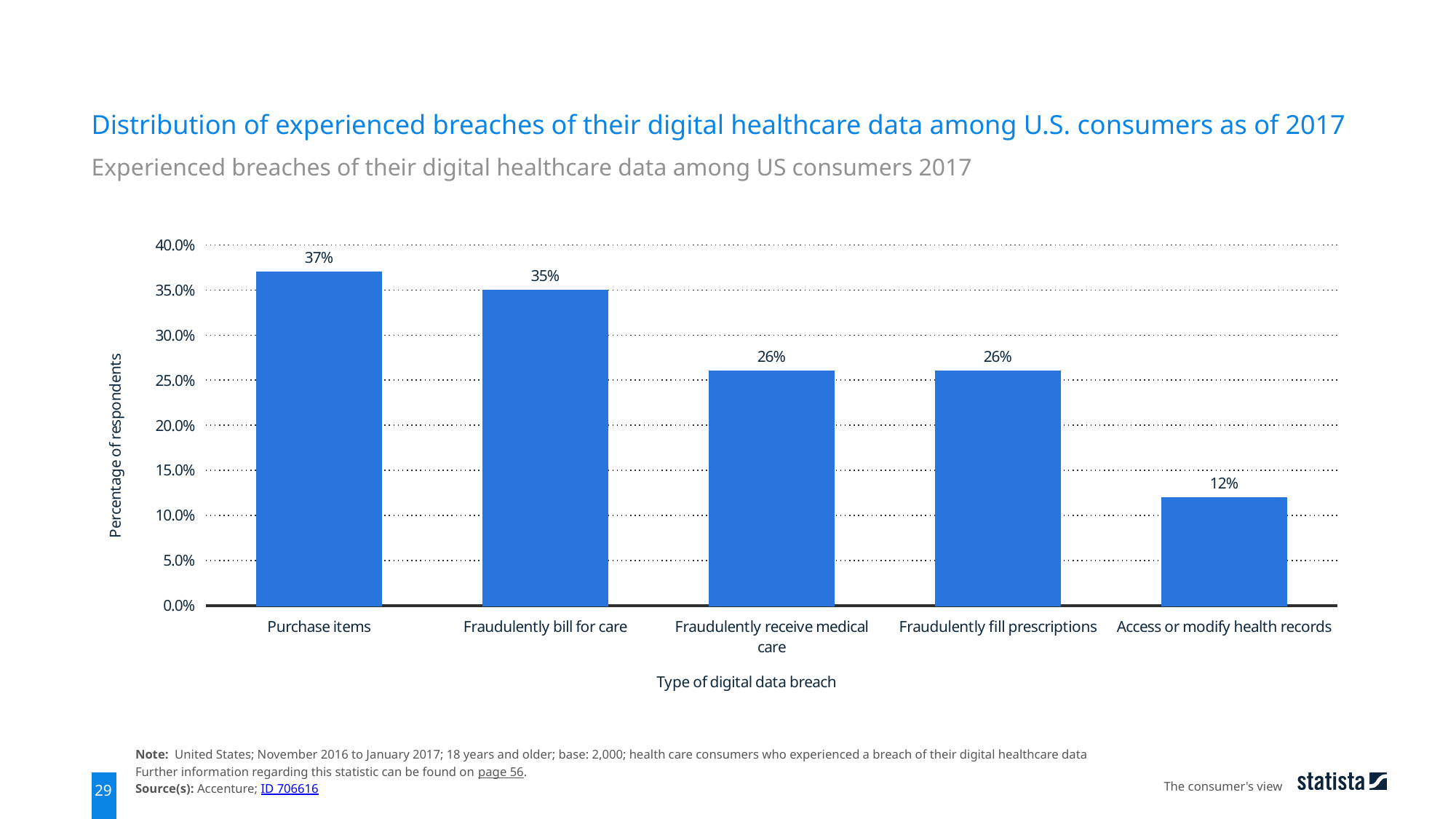
What percentage of respondents experienced a breach used to purchase items? 37% Is the value for 'Fraudulently receive medical care' greater or less than 30.0%? less Which is larger: the value for 'Fraudulently bill for care' or 'Fraudulently receive medical care'? Fraudulently bill for care Which type of digital data breach has the highest percentage of respondents? Purchase items What is the label of the y-axis? Percentage of respondents What is the value for 'Fraudulently fill prescriptions'? 26% Which type of digital data breach has the lowest percentage of respondents? Access or modify health records How many types of digital data breach are shown in the chart? 5 What is the value for 'Fraudulently bill for care'? 35% What kind of chart is shown on the slide? Bar chart What is the difference in percentage points between 'Purchase items' and 'Access or modify health records'? 25 What percentage of respondents reported 'Access or modify health records'? 12%